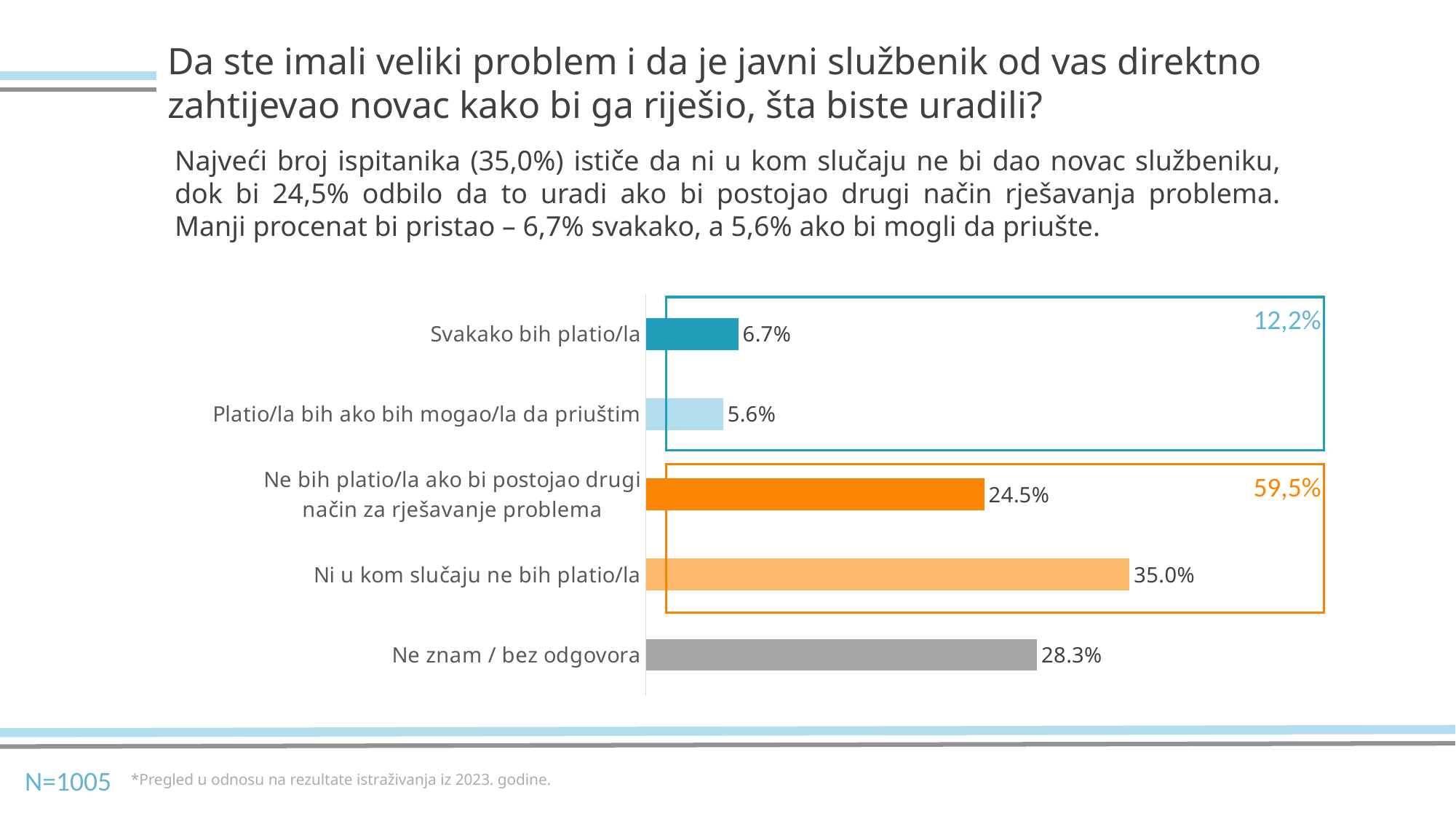
What is the value for "Platio/la bih ako bih mogao/la da priuštim"? 5.6% What combined percentage is shown in the orange box grouping the two "would not pay" categories? 59,5% Which category has the lowest value? Platio/la bih ako bih mogao/la da priuštim What kind of chart is shown on the slide? Bar chart What is the value for "Ni u kom slučaju ne bih platio/la"? 35.0% How many categories are shown in the chart? 5 What combined percentage is shown in the blue box grouping the two "would pay" categories? 12,2% Which is larger: "Ne znam / bez odgovora" or "Ne bih platio/la ako bi postojao drugi način za rješavanje problema"? Ne znam / bez odgovora Which category has the highest value? Ni u kom slučaju ne bih platio/la What is the value for "Ne znam / bez odgovora"? 28.3% What is the value for "Svakako bih platio/la"? 6.7% What is the difference between "Ni u kom slučaju ne bih platio/la" and "Ne bih platio/la ako bi postojao drugi način za rješavanje problema"? 10.5%